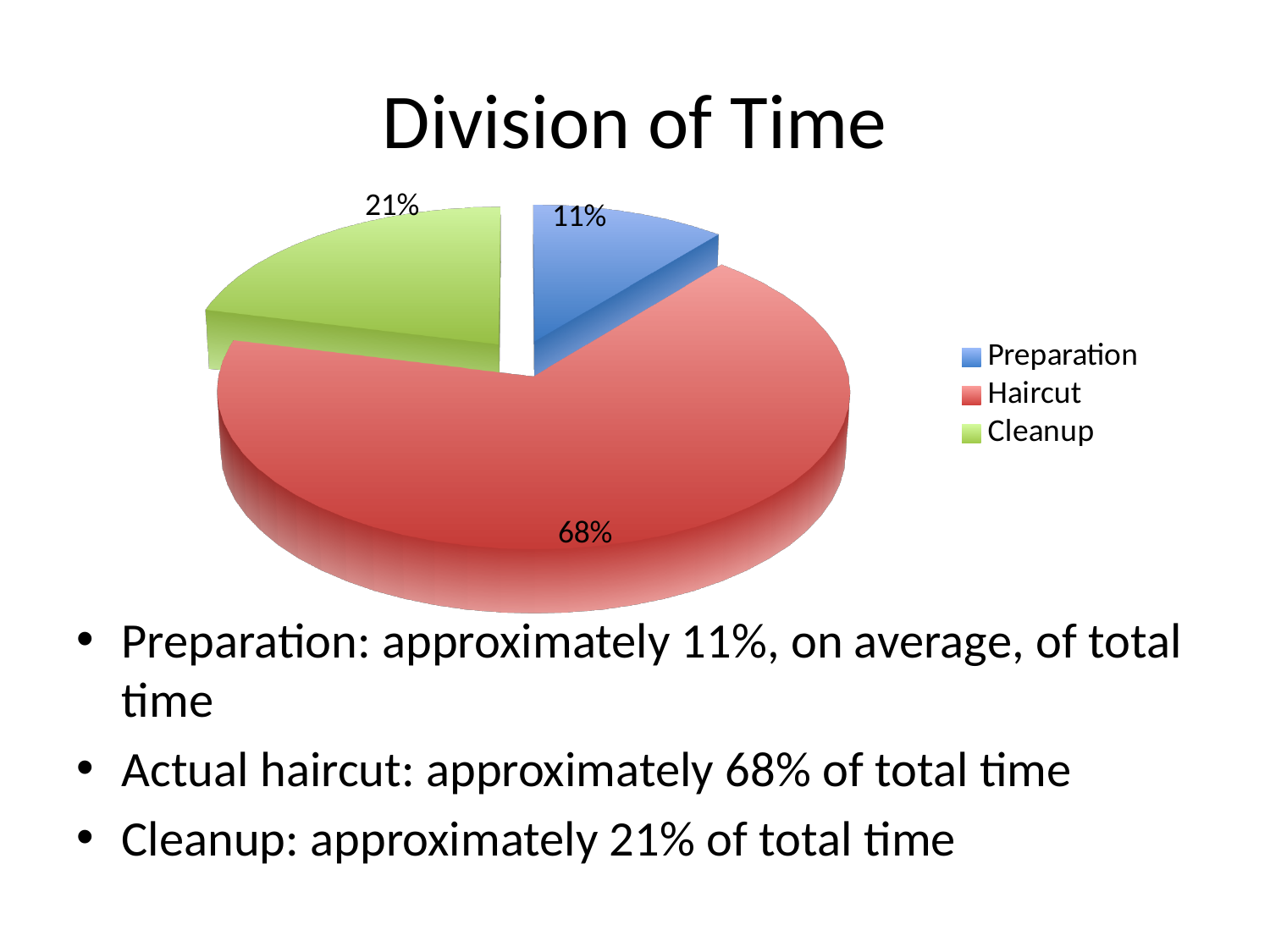
Which slice is larger, Cleanup or Preparation? Cleanup Which category has the largest slice of the pie? Haircut What kind of chart is shown on the slide? Pie chart What is the difference in percentage points between the Haircut and Cleanup slices? 47 What is the title of the chart? Division of Time Which colour represents Cleanup in the pie chart? Green What share of the pie does Haircut take? 68% What share of the pie does Preparation take? 11% Which category has the smallest slice of the pie? Preparation How many slices does the pie chart have? 3 What share of the pie does Cleanup take? 21% What is the difference in percentage points between the Cleanup and Preparation slices? 10